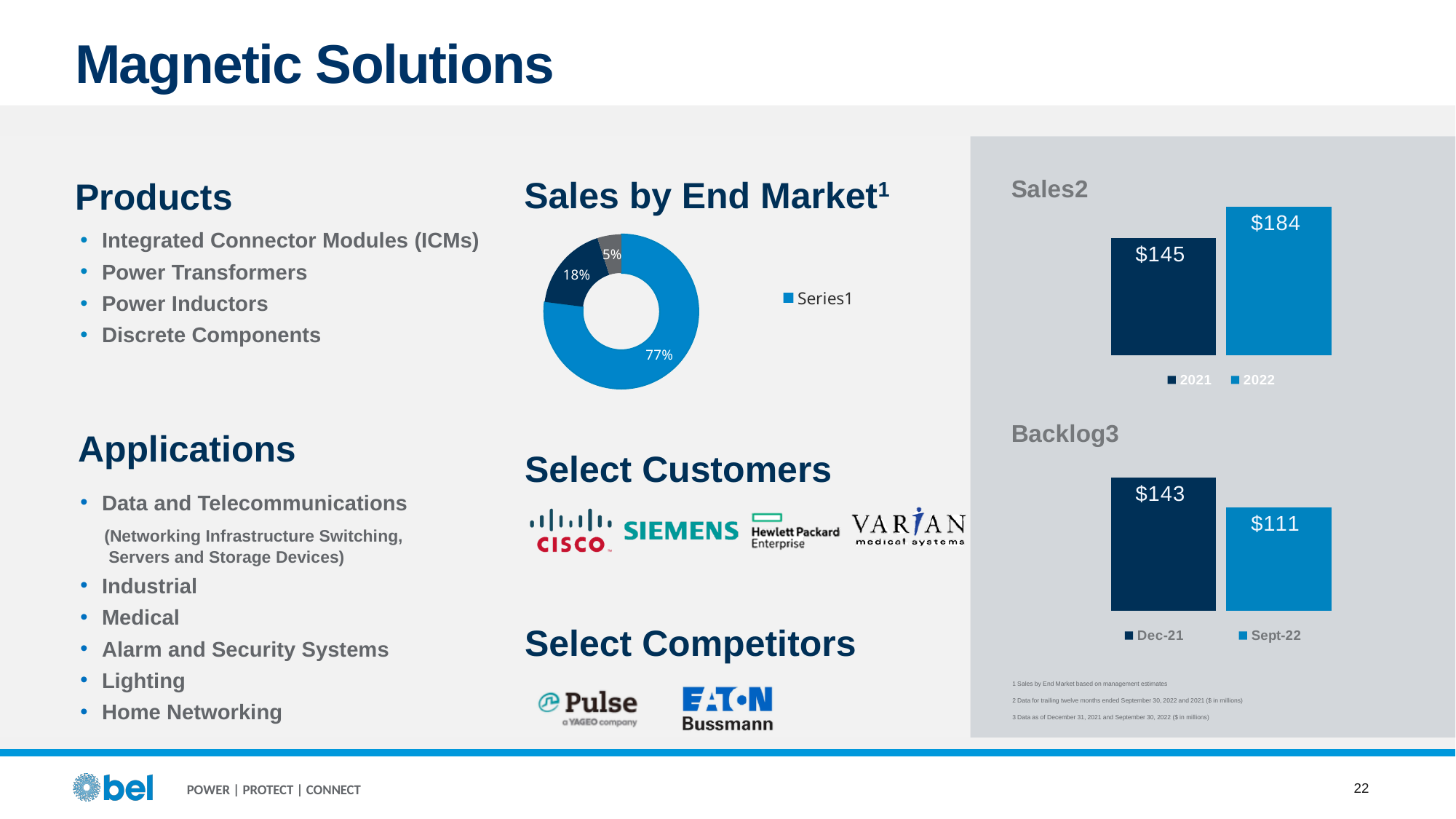
In the Backlog chart, what is the value for Sept-22? $111 In the Sales chart, which year has the higher value, 2021 or 2022? 2022 In the Backlog chart, what is the value for Dec-21? $143 In the Sales by End Market chart, what is the percentage of the smallest slice? 5% What kind of chart is the Backlog chart? bar chart How many slices does the Sales by End Market chart have? 3 In the Sales chart, what is the value for 2021? $145 In the Backlog chart, do values rise or fall from Dec-21 to Sept-22? fall In the Backlog chart, what is the difference between the Dec-21 and Sept-22 values? $32 In the Sales chart, what is the value for 2022? $184 In the Sales chart, what is the difference between the 2022 and 2021 values? $39 In the Sales by End Market chart, what is the percentage of the largest slice? 77%